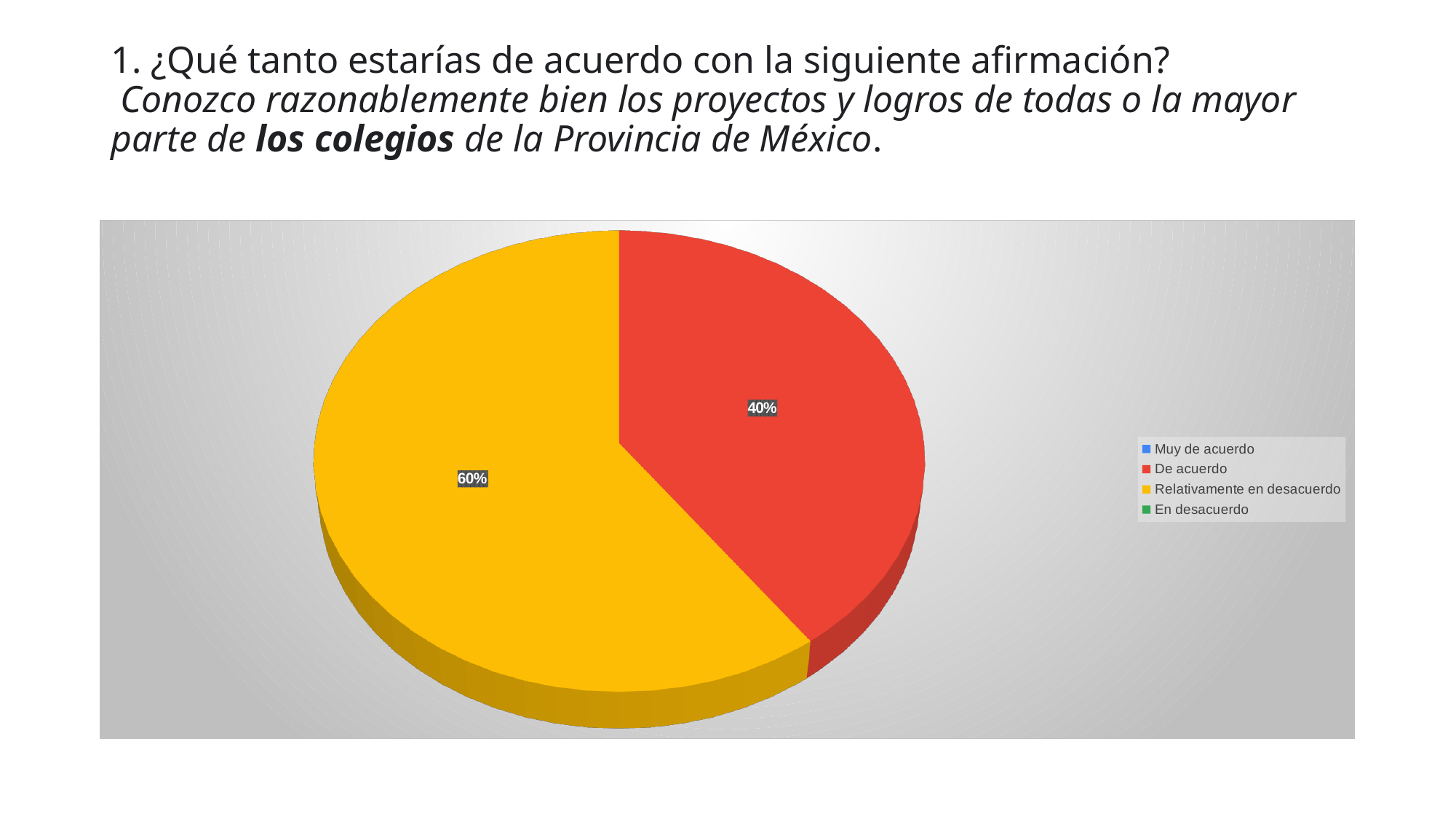
Which is larger, the slice for "De acuerdo" or the slice for "Relativamente en desacuerdo"? Relativamente en desacuerdo How many slices are visible in the pie? 2 What kind of chart is shown on the slide? pie chart What is the difference in percentage points between the "Relativamente en desacuerdo" slice and the "De acuerdo" slice? 20% Is the share for "De acuerdo" greater or less than 50%? less What share of the pie does "Relativamente en desacuerdo" represent? 60% How many entries does the legend list? 4 Which category has the largest slice of the pie? Relativamente en desacuerdo Which legend entry is shown in yellow? Relativamente en desacuerdo What colour is the slice for "De acuerdo"? red What share of the pie does "De acuerdo" represent? 40%